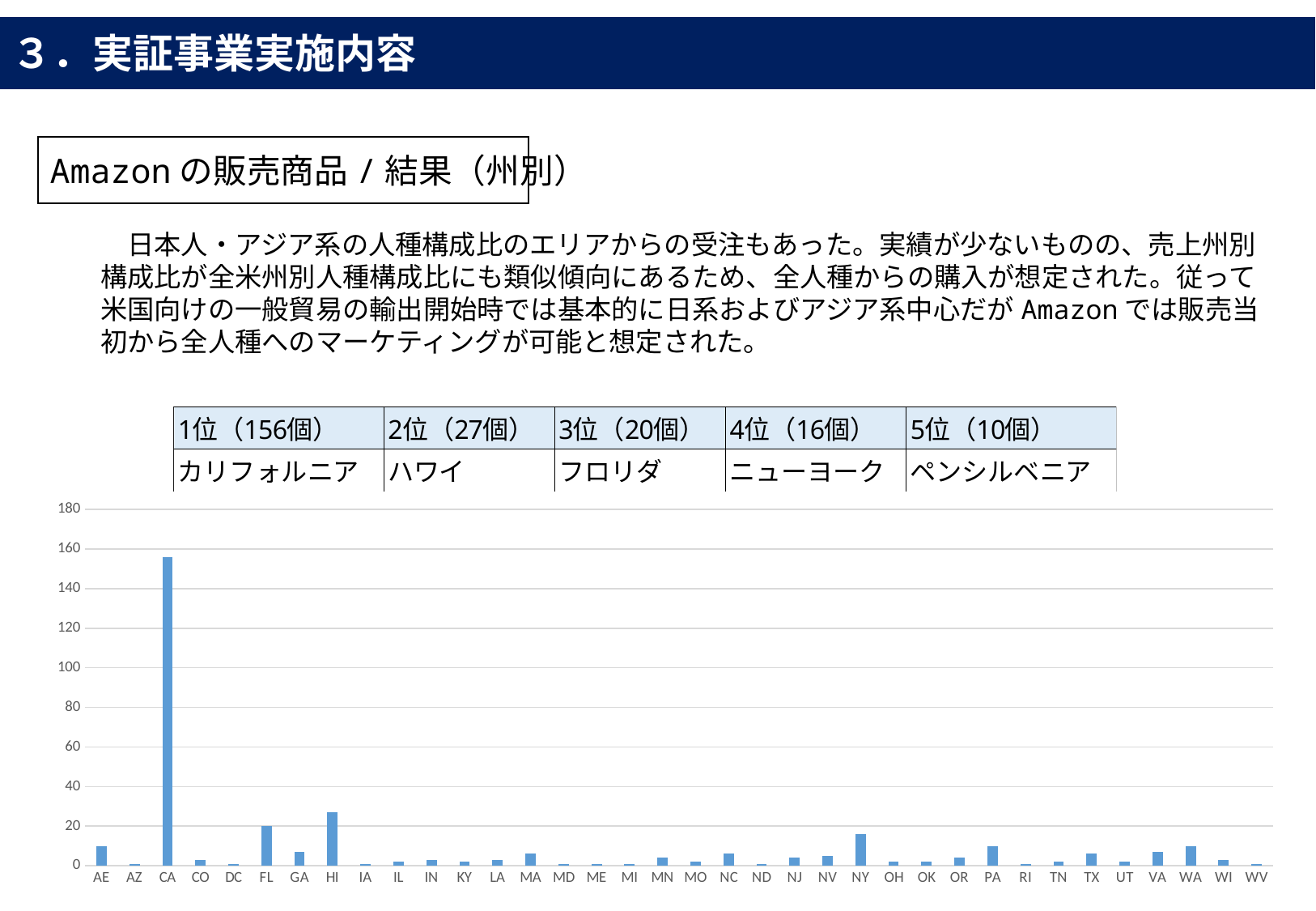
Which state has the larger bar, HI or FL? HI Is the value for WA greater or less than 20? less Is the value for CA greater or less than 140? greater According to the slide, how many items were sold in Florida (FL)? 20個 According to the slide, how many items were sold in California (CA)? 156個 Which state has the highest bar in the chart? CA According to the slide, how many items were sold in Hawaii (HI)? 27個 What is the difference between the number of items sold in California (156個) and Hawaii (27個)? 129個 How many states are shown along the x axis of the chart? 36 What is the difference between the number of items sold in Florida (20個) and New York (16個)? 4個 What kind of chart is shown on the slide? bar chart According to the slide, how many items were sold in Pennsylvania (PA)? 10個